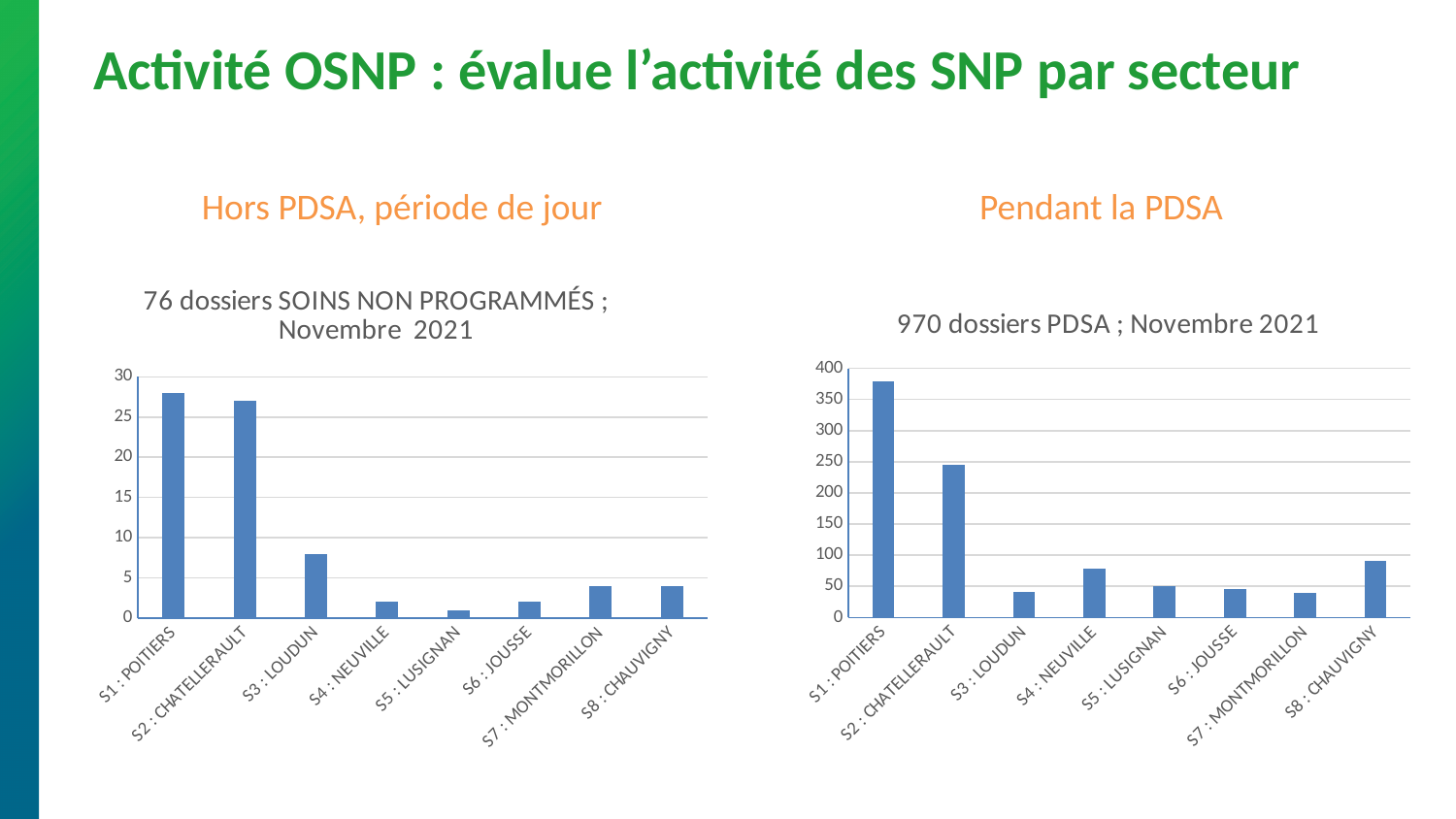
In the left chart (76 dossiers SOINS NON PROGRAMMÉS), is the value for S1 : POITIERS greater or less than 25? greater What is the title of the chart under the heading "Pendant la PDSA"? 970 dossiers PDSA ; Novembre 2021 In the left chart (76 dossiers SOINS NON PROGRAMMÉS), is the value for S3 : LOUDUN greater or less than 5? greater In the right chart (970 dossiers PDSA), is the value for S8 : CHAUVIGNY greater or less than 50? greater In the chart titled "970 dossiers PDSA ; Novembre 2021", which sector has the highest value? S1 : POITIERS How many sectors are shown on the x axis of the chart titled "970 dossiers PDSA ; Novembre 2021"? 8 In the right chart (970 dossiers PDSA), which is larger, the value for S4 : NEUVILLE or S3 : LOUDUN? S4 : NEUVILLE What kind of chart is the left chart (76 dossiers SOINS NON PROGRAMMÉS)? Bar chart In the chart titled "76 dossiers SOINS NON PROGRAMMÉS ; Novembre 2021", which sector has the lowest value? S5 : LUSIGNAN In the left chart (76 dossiers SOINS NON PROGRAMMÉS), which is larger, the value for S3 : LOUDUN or S7 : MONTMORILLON? S3 : LOUDUN